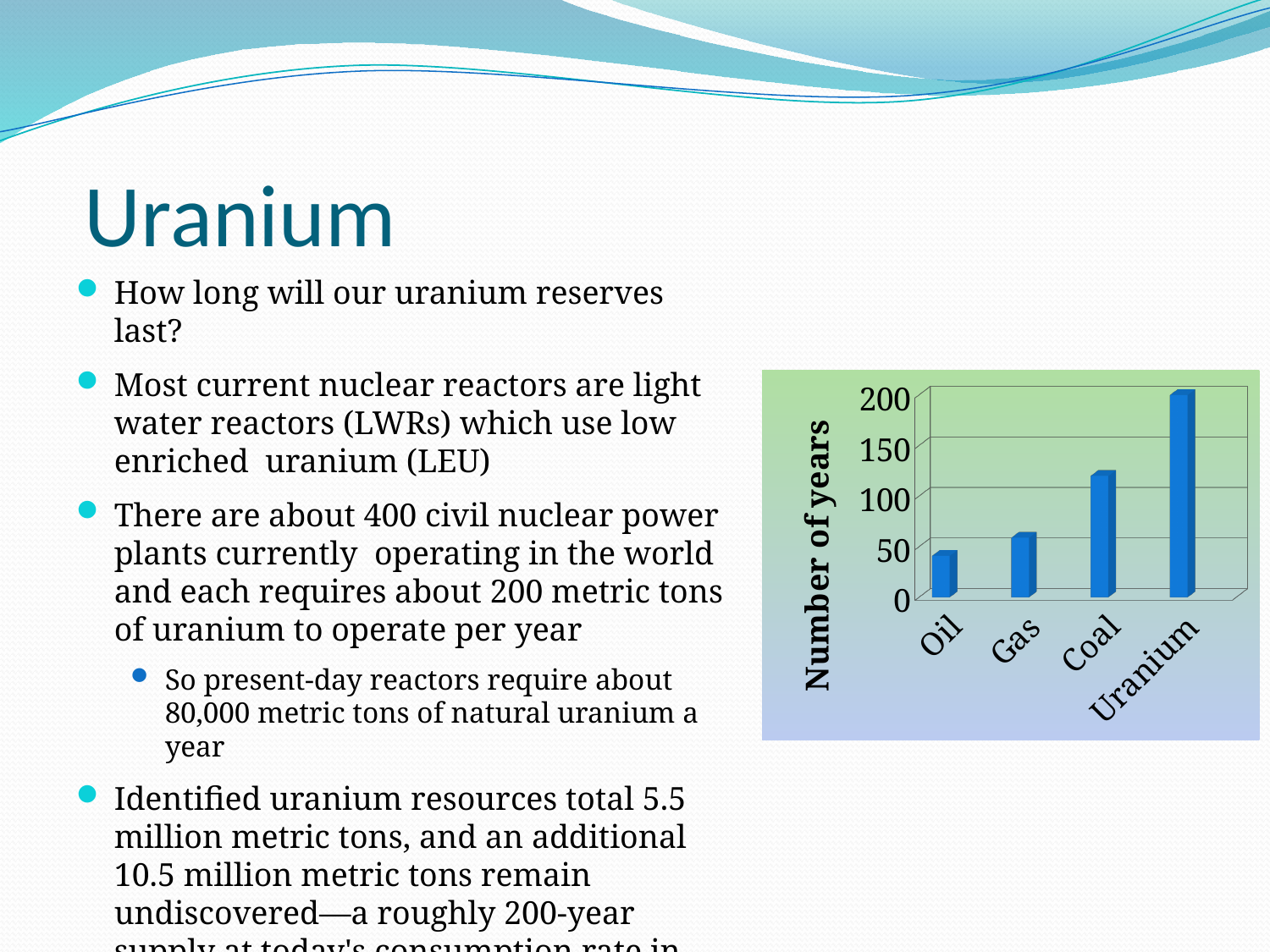
Do the values rise or fall moving from Oil to Uranium along the x axis? rise Which has a larger value, Oil or Uranium? Uranium Which category has the lowest number of years? Oil Is the value for Oil greater or less than 50? less Which has a larger value, Coal or Gas? Coal Is the value for Coal greater or less than 100? greater Which category has the highest number of years? Uranium Is the value for Gas greater or less than 100? less What kind of chart is shown on the slide? bar chart What is the label on the vertical axis of the chart? Number of years How many categories are plotted on the chart? 4